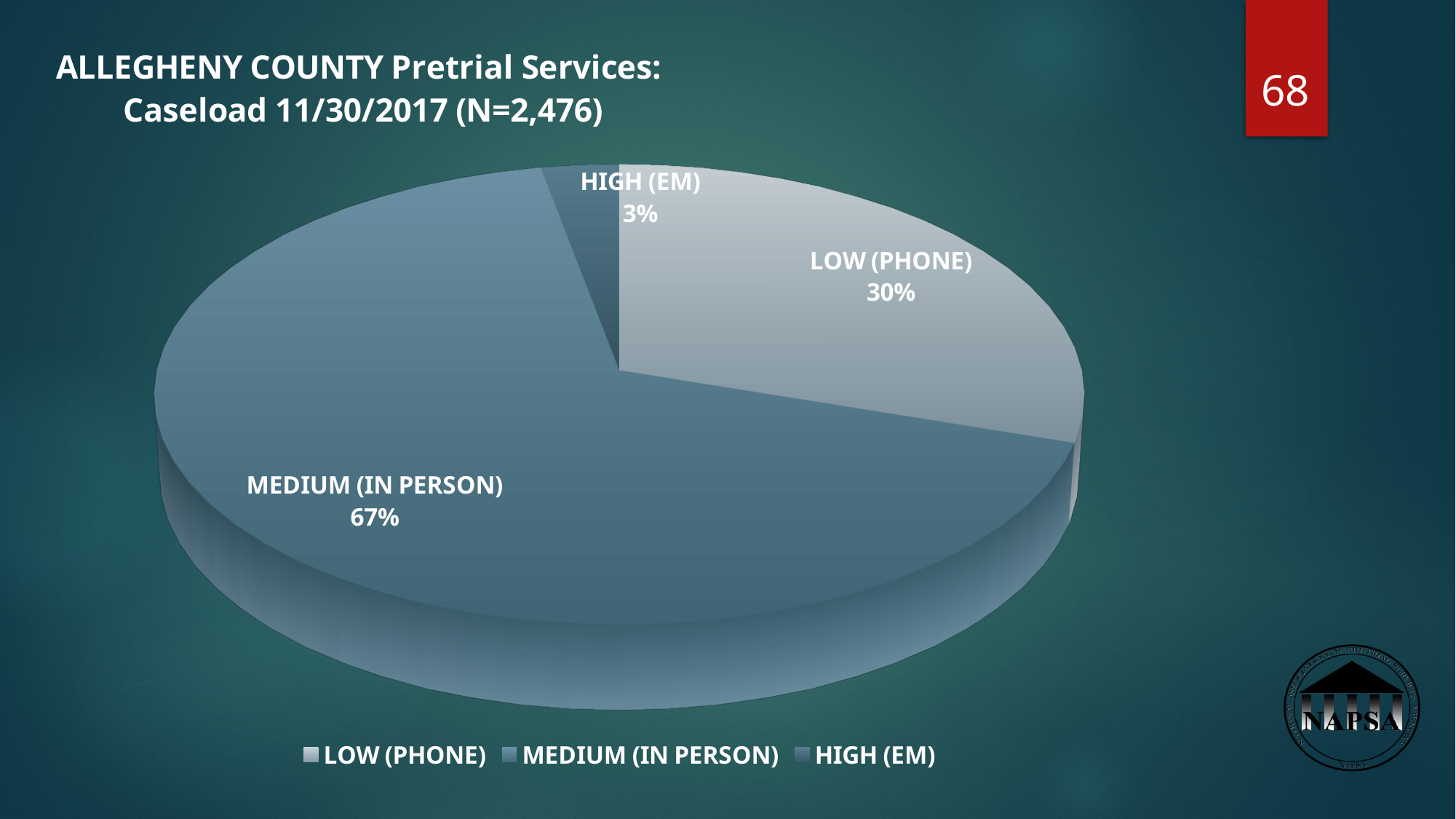
How many slices does the pie chart have? 3 Which category has the smallest share of the pie? HIGH (EM) What is the title of the chart? ALLEGHENY COUNTY Pretrial Services: Caseload 11/30/2017 (N=2,476) What share of the caseload is LOW (PHONE)? 30% What is the difference in percentage points between MEDIUM (IN PERSON) and LOW (PHONE)? 37 Which is larger, the LOW (PHONE) share or the HIGH (EM) share? LOW (PHONE) What share of the caseload is HIGH (EM)? 3% Which category has the largest share of the pie? MEDIUM (IN PERSON) What kind of chart is shown on the slide? Pie chart What is the difference in percentage points between LOW (PHONE) and HIGH (EM)? 27 What share of the caseload is MEDIUM (IN PERSON)? 67% What is the total N stated in the chart title? 2,476